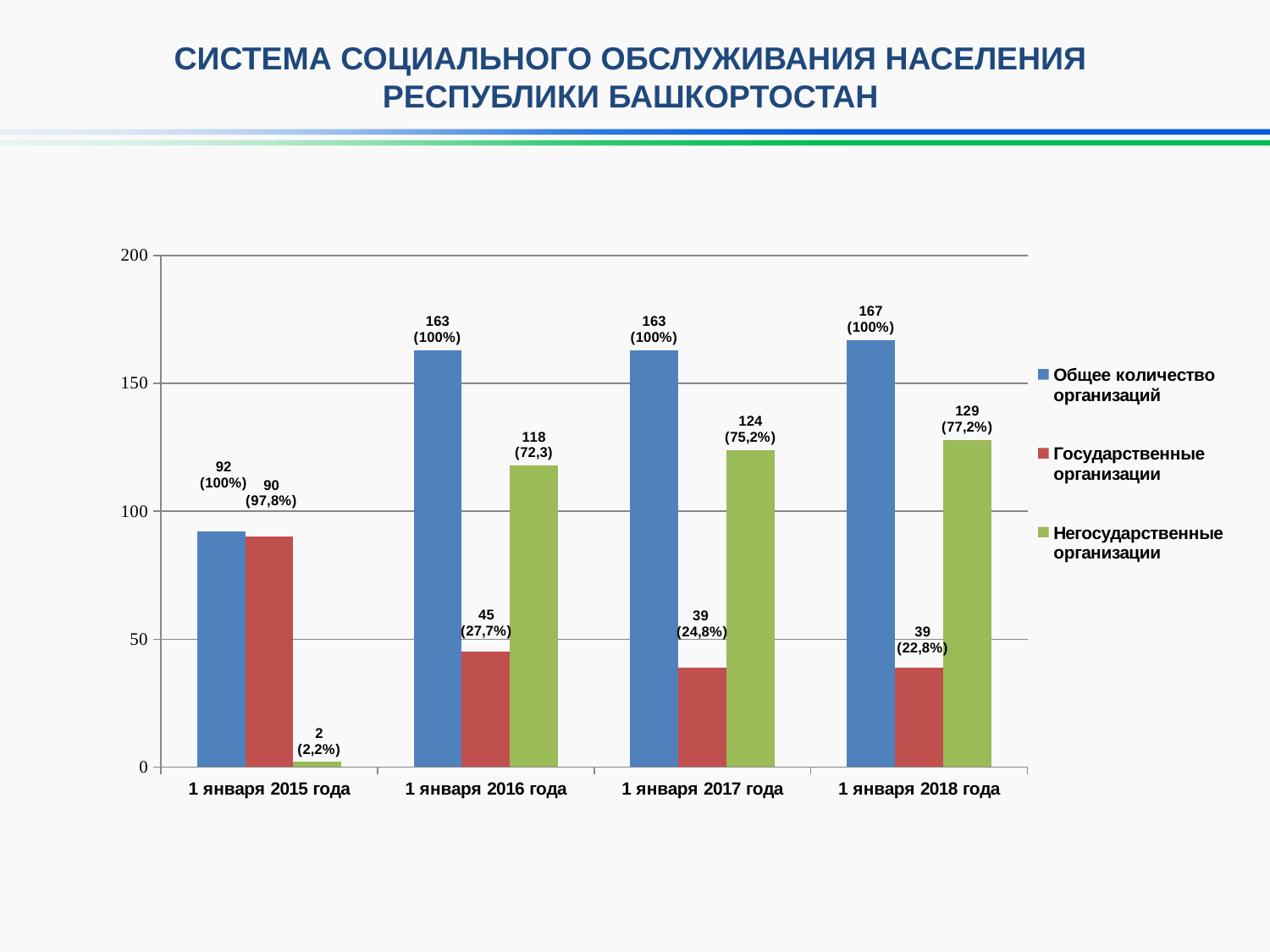
What is the value for Общее количество организаций on 1 января 2018 года? 167 (100%) On which date is the value for Общее количество организаций lowest? 1 января 2015 года What is the value for Негосударственные организации on 1 января 2016 года? 118 (72,3) Which is larger on 1 января 2016 года: Государственные организации or Негосударственные организации? Негосударственные организации What is the value for Государственные организации on 1 января 2015 года? 90 (97,8%) On which date is the value for Негосударственные организации highest? 1 января 2018 года What is the difference between Негосударственные организации and Государственные организации on 1 января 2017 года? 85 What type of chart is shown on the slide? bar chart Does the value for Государственные организации rise or fall from 1 января 2015 года to 1 января 2018 года? fall How many series does the legend list? 3 What is the value for Негосударственные организации on 1 января 2015 года? 2 (2,2%) How many date categories are shown on the x axis? 4